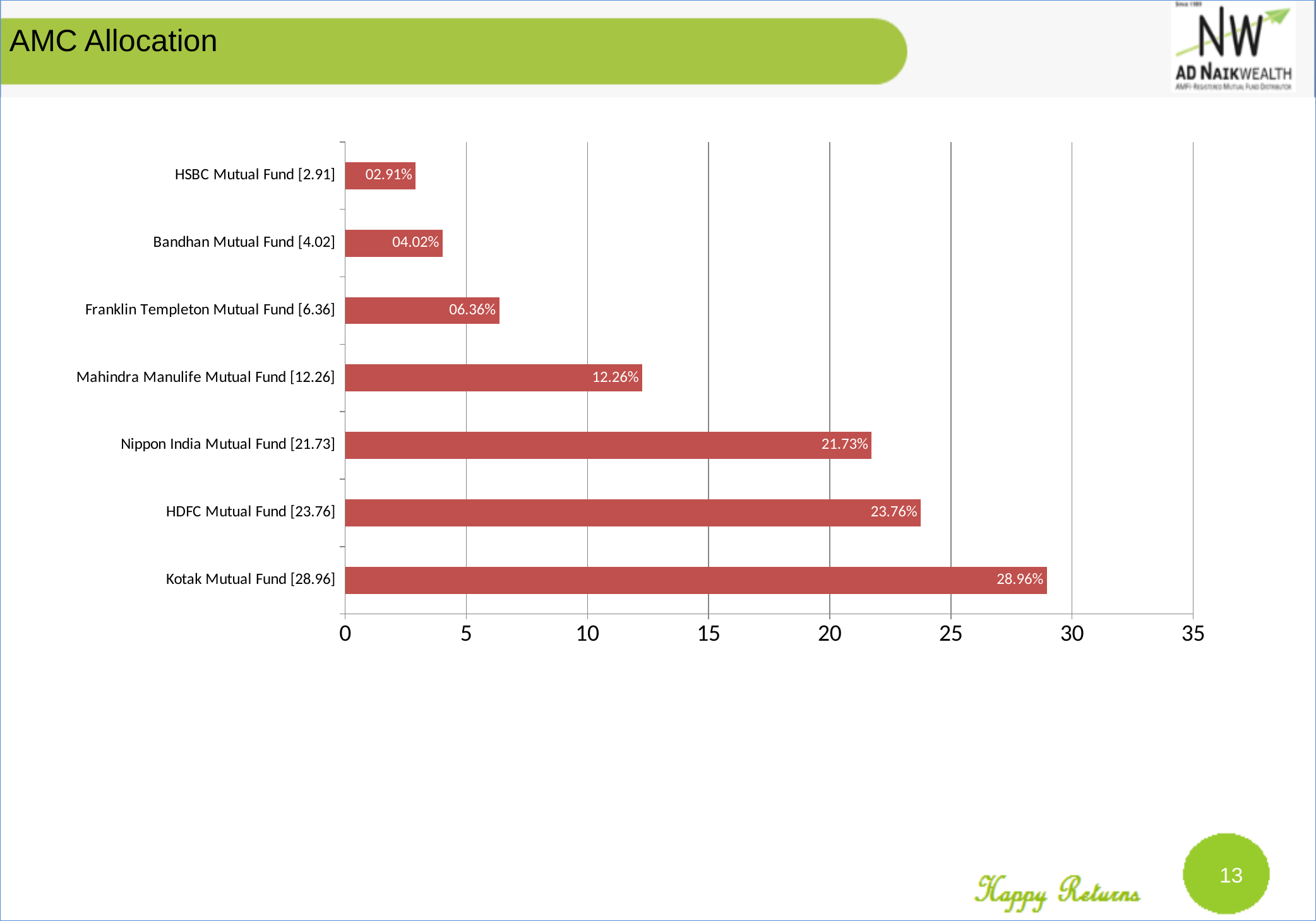
What is the value shown for Mahindra Manulife Mutual Fund? 12.26% What is the value shown for Kotak Mutual Fund? 28.96% What is the difference between the allocations of Kotak Mutual Fund and HDFC Mutual Fund? 5.20% Which fund has the highest allocation? Kotak Mutual Fund What is the value shown for HSBC Mutual Fund? 02.91% Is the value for Nippon India Mutual Fund greater or less than 20? greater How many funds are shown in the chart? 7 What is the difference between the allocations of Nippon India Mutual Fund and Mahindra Manulife Mutual Fund? 9.47% Which fund has the lowest allocation? HSBC Mutual Fund What is the title of the slide? AMC Allocation Which has a larger allocation, Franklin Templeton Mutual Fund or Bandhan Mutual Fund? Franklin Templeton Mutual Fund What kind of chart is shown on the slide? Bar chart